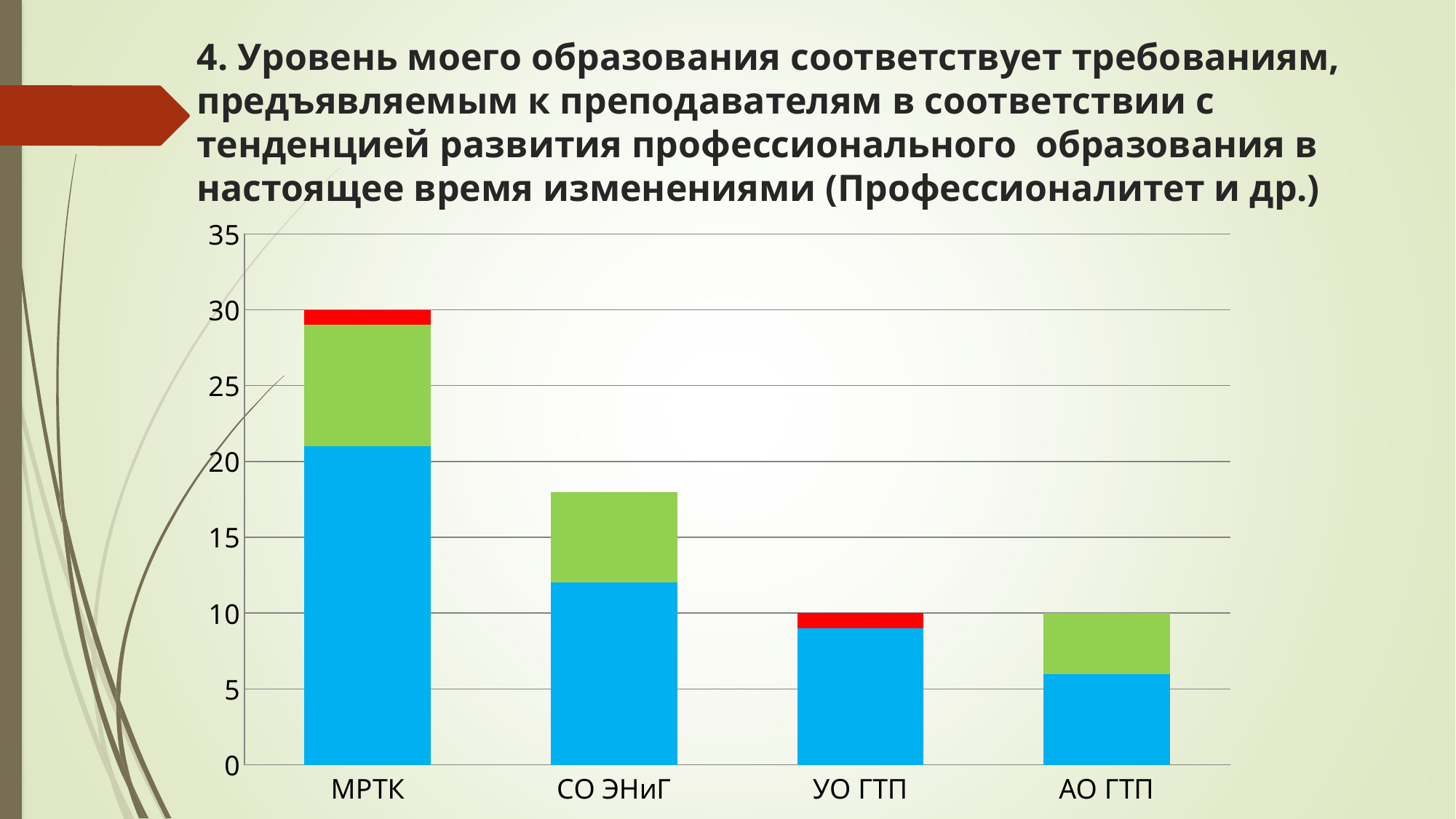
What kind of chart is shown on the slide? Stacked bar chart Is the total bar height for СО ЭНиГ greater or less than 15? greater How many categories are shown on the x axis of the chart? 4 What is the total height of the stacked bar for АО ГТП? 10 Which has the taller stacked bar, МРТК or СО ЭНиГ? МРТК What colour is the bottom segment of each stacked bar? Blue What is the difference between the total bar heights for МРТК and УО ГТП? 20 What is the total height of the stacked bar for УО ГТП? 10 Is the blue segment for СО ЭНиГ greater or less than 10? greater Which category has the tallest stacked bar? МРТК Is the total bar height for СО ЭНиГ greater or less than 20? less What is the total height of the stacked bar for МРТК? 30